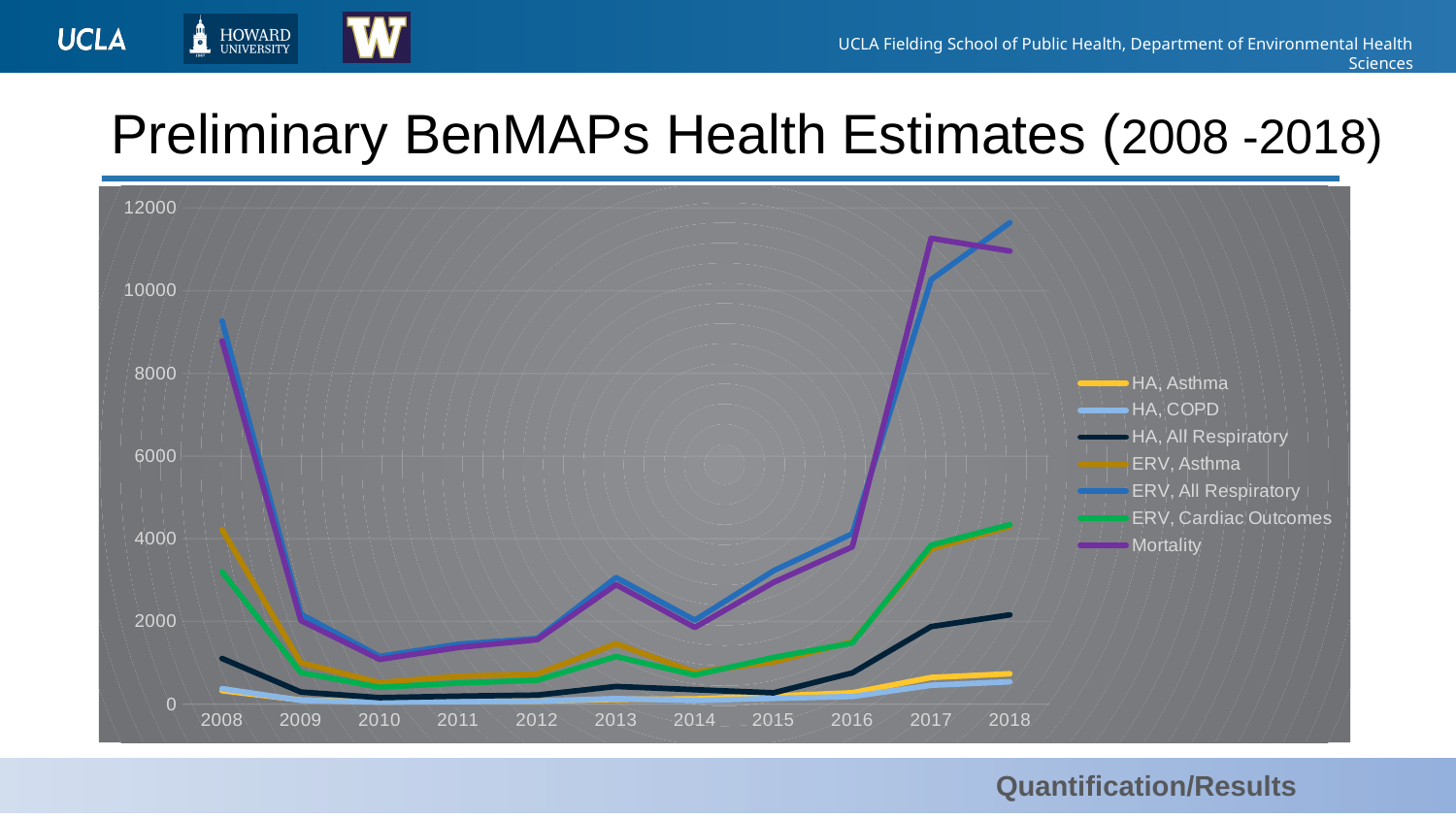
In which year does ERV, All Respiratory reach its highest value? 2018 Is the value for HA, All Respiratory in 2018 greater or less than 1000? greater In 2018, which is larger: ERV, All Respiratory or HA, Asthma? ERV, All Respiratory How many years are shown along the x axis? 11 Is the value for Mortality in 2010 greater or less than 2000? less What kind of chart is shown on the slide? line chart Is the value for ERV, All Respiratory in 2018 greater or less than 10000? greater How many series does the legend list? 7 Which series is drawn in purple? Mortality Do the values for ERV, All Respiratory rise or fall from 2016 to 2018? rise In 2017, which is larger: Mortality or ERV, All Respiratory? Mortality